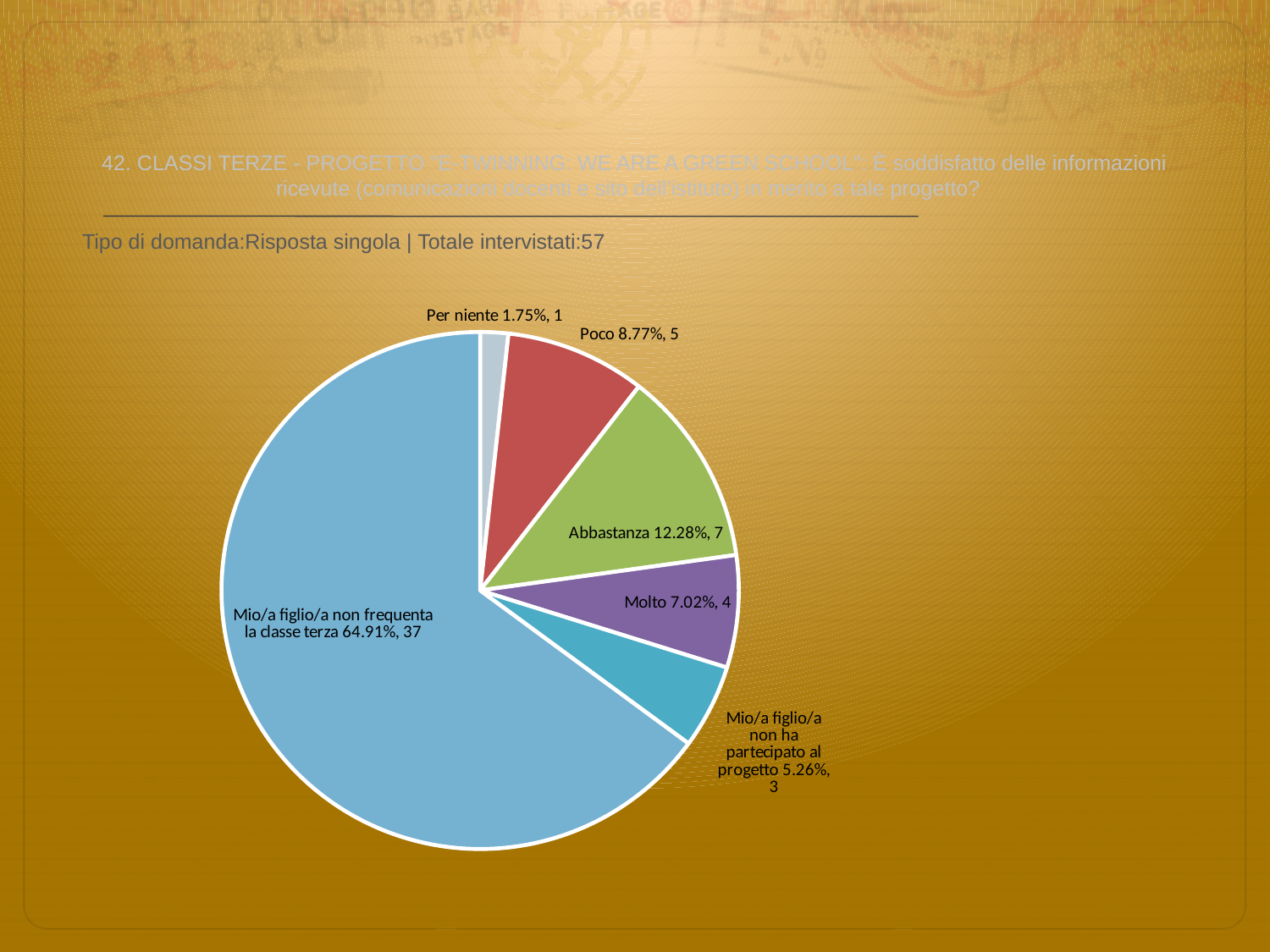
Which category has the smallest slice of the pie? Per niente Which category has the largest slice of the pie? Mio/a figlio/a non frequenta la classe terza What colour is the 'Abbastanza' slice? green What is the difference in count between 'Abbastanza' and 'Molto'? 3 Which slice is larger, 'Poco' or 'Molto'? Poco What percentage share does the 'Poco' slice have? 8.77% What percentage share does the 'Molto' slice have? 7.02% How many slices does the pie chart have? 6 What percentage share does the 'Mio/a figlio/a non frequenta la classe terza' slice have? 64.91% How many respondents answered 'Abbastanza'? 7 What kind of chart is shown on the slide? pie chart How many respondents answered 'Mio/a figlio/a non ha partecipato al progetto'? 3